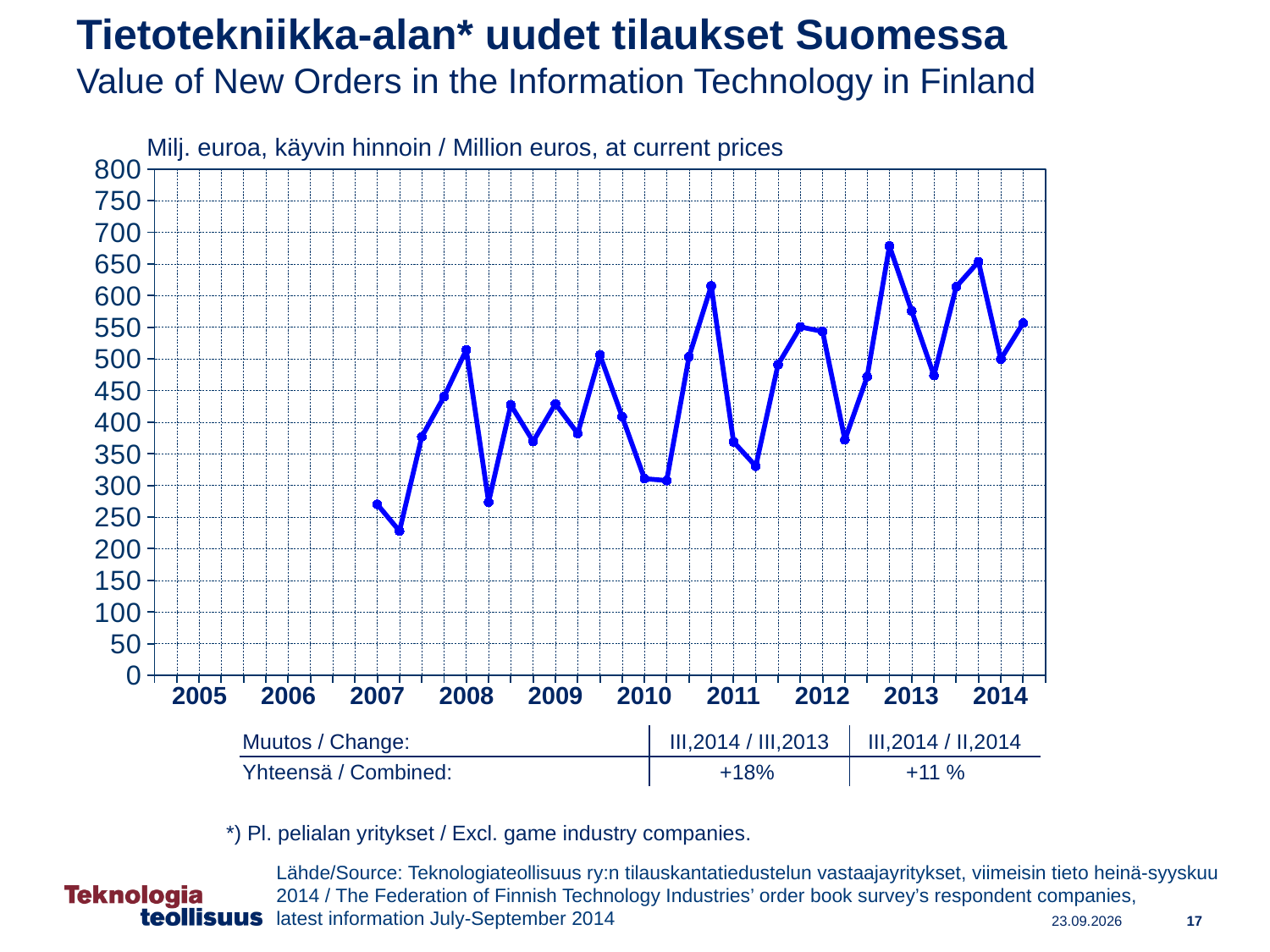
Is the lowest point on the line greater or less than 250? less What is the combined change for III,2014 compared with III,2013 shown in the table below the chart? +18% Is the last plotted value in 2014 greater or less than 500? greater Is the highest point on the line greater or less than 650? greater What is the title of the chart in English? Value of New Orders in the Information Technology in Finland What is the combined change for III,2014 compared with II,2014 shown in the table below the chart? +11 % What unit is the y axis measured in, according to the label above the chart? Million euros, at current prices Which is larger, the first plotted value in 2007 or the last plotted value in 2014? the last plotted value in 2014 Overall, do the values rise or fall from 2007 to 2014? rise What is the maximum value shown on the y axis? 800 What kind of chart is shown on the slide? line chart